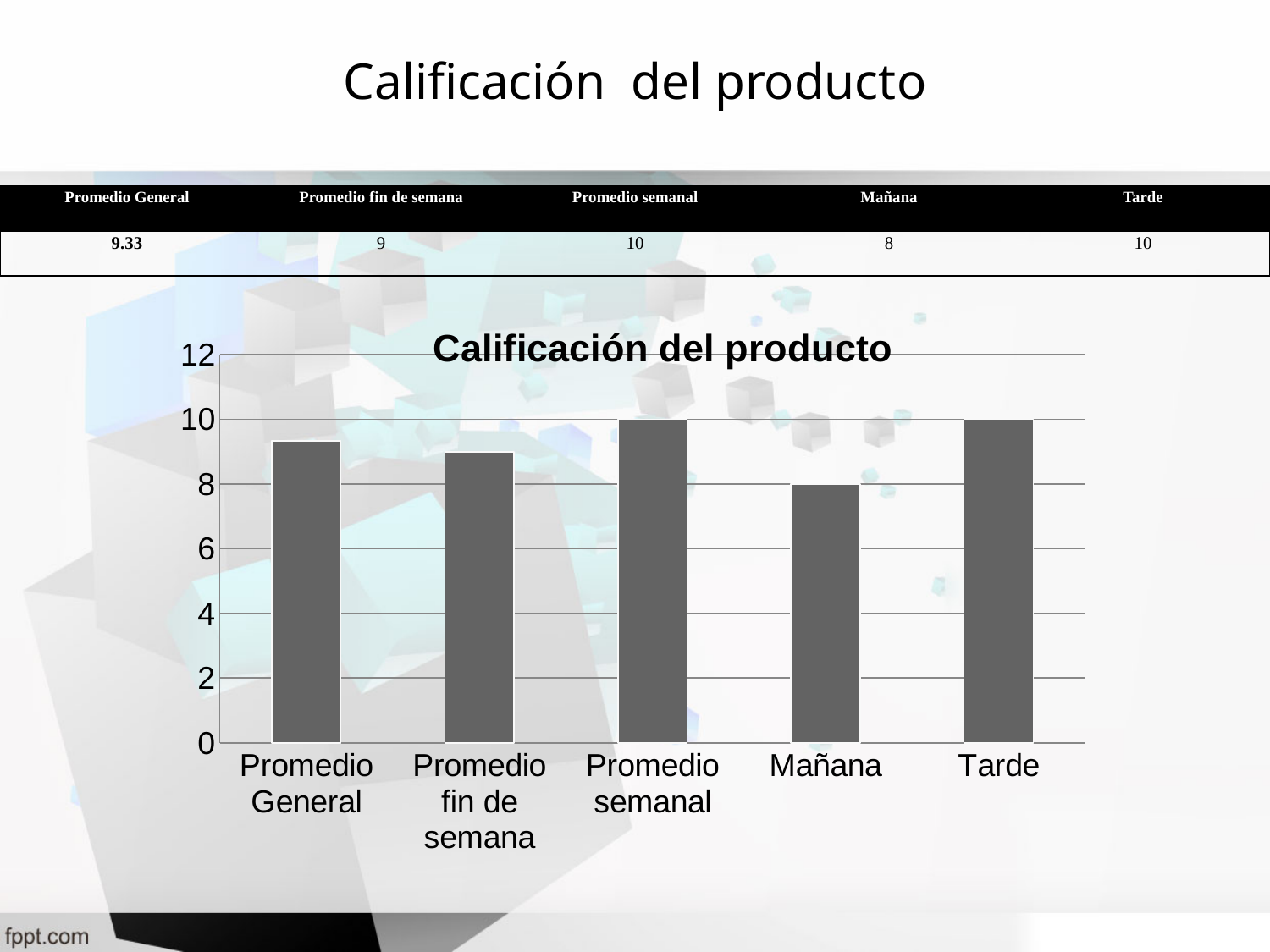
What is the value for Mañana in the Calificación del producto chart? 8 What is the value for Promedio General shown on the slide? 9.33 What is the difference between the values for Promedio semanal and Promedio fin de semana? 1 What is the value for Tarde in the Calificación del producto chart? 10 Which is larger, the value for Mañana or the value for Tarde? Tarde Which category has the lowest value in the Calificación del producto chart? Mañana What kind of chart is shown on the slide? Bar chart Is the value for Promedio General greater or less than 8? greater How many categories are shown in the Calificación del producto chart? 5 What is the value for Promedio semanal in the chart? 10 What is the title of the chart on the slide? Calificación del producto What is the difference between the values for Tarde and Mañana? 2